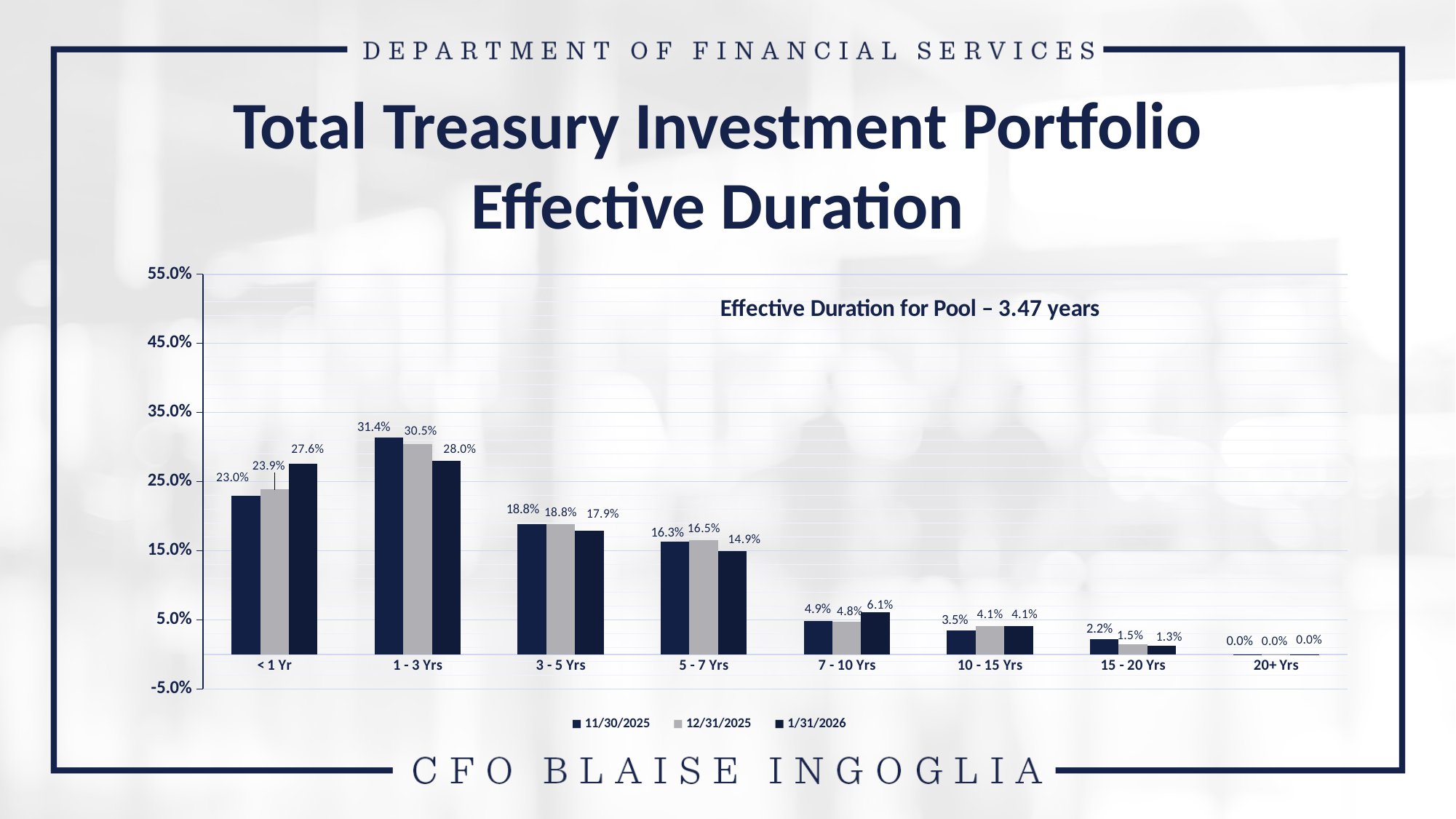
How many maturity categories are shown on the x axis? 8 Which category has the highest value in the 1/31/2026 series? 1 - 3 Yrs What is the value for < 1 Yr in the 1/31/2026 series? 27.6% Do the 1/31/2026 values rise or fall from 1 - 3 Yrs to 20+ Yrs? Fall What is the difference between the 11/30/2025 and 1/31/2026 values for 1 - 3 Yrs? 3.4% Which category has the lowest value in the 11/30/2025 series? 20+ Yrs What kind of chart is shown on the slide? Bar chart What is the value for 7 - 10 Yrs in the 12/31/2025 series? 4.8% How many series does the legend list? 3 What is the effective duration for the pool stated on the chart? 3.47 years Which is larger for < 1 Yr: the 11/30/2025 value or the 1/31/2026 value? 1/31/2026 What is the value for 1 - 3 Yrs in the 11/30/2025 series? 31.4%